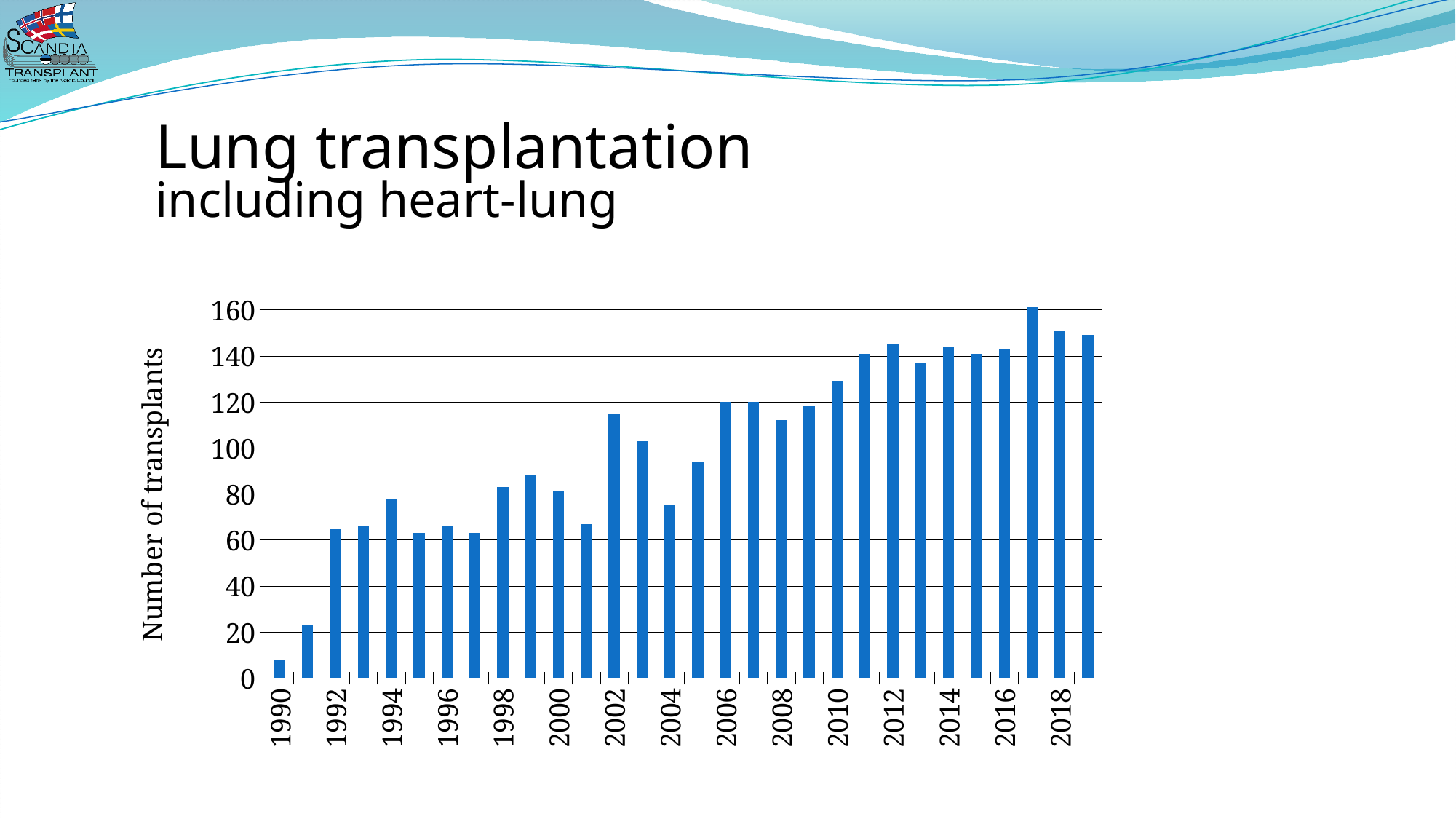
Which year has more transplants, 2002 or 2003? 2002 Is the value for 2005 greater or less than 100? less Is the value for 2010 greater or less than 120? greater What is the label on the vertical axis of the chart? Number of transplants How many years (bars) are plotted in the chart? 30 Is the value for 1990 greater or less than 20? less What kind of chart is shown on the slide? bar chart Overall, do the number of transplants rise or fall from 1990 to 2019? rise Which year has the highest number of transplants? 2017 Which year has the lowest number of transplants? 1990